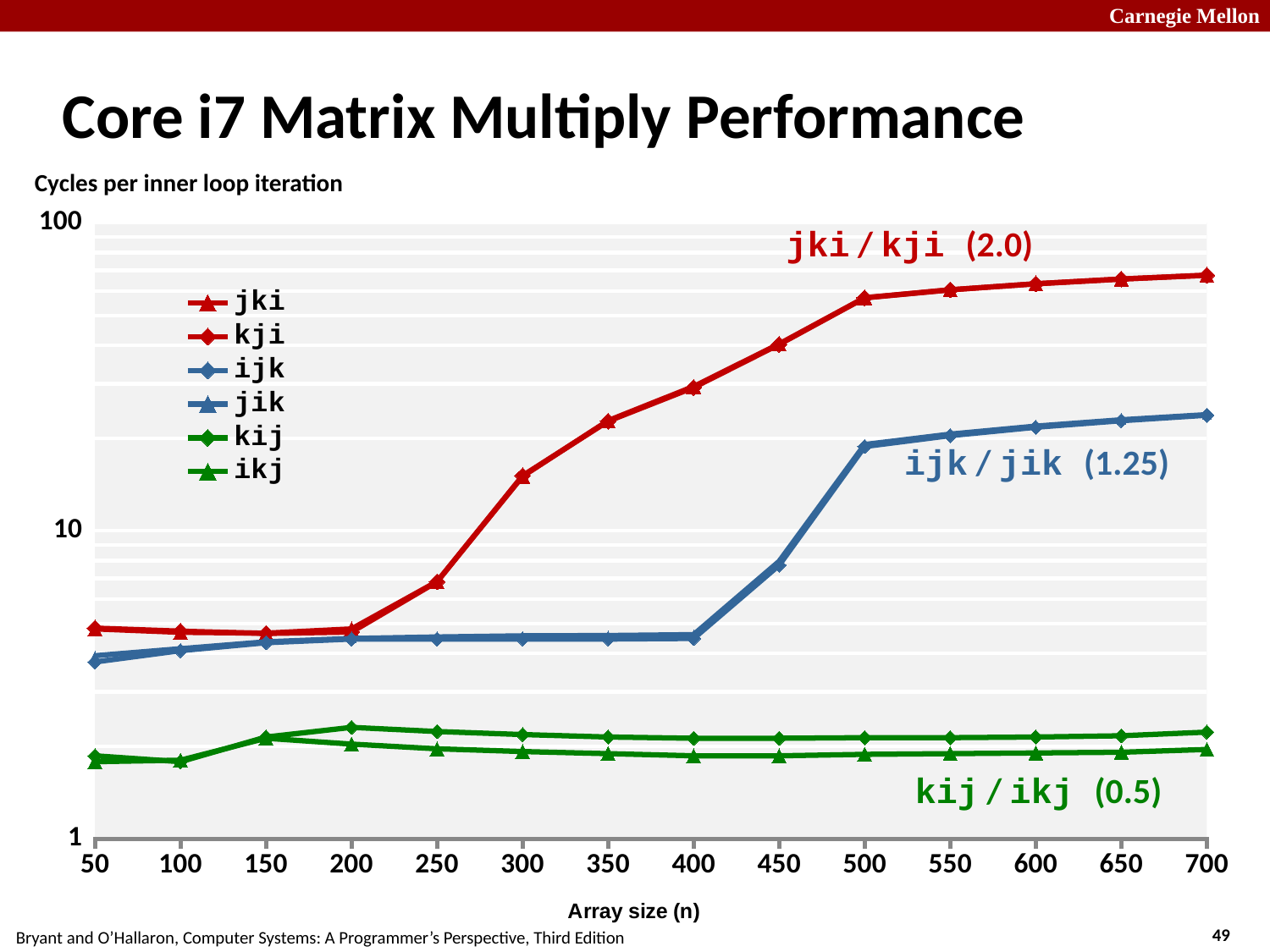
Do the values for jki rise or fall as the array size increases from 200 to 700? rise Which is larger at array size 300, the value for jki or the value for ijk? jki Is the value for jki at array size 700 greater or less than 10? greater Which is larger at array size 700, the value for jki or the value for kij? jki What ratio is annotated next to the ijk / jik lines? 1.25 What kind of chart is shown on the slide? line chart How many array sizes (x-axis points) are plotted for each series? 14 What is the label of the x axis? Array size (n) How many series does the legend list? 6 Is the value for ijk at array size 200 greater or less than 10? less Is the value for kij at array size 700 greater or less than 10? less